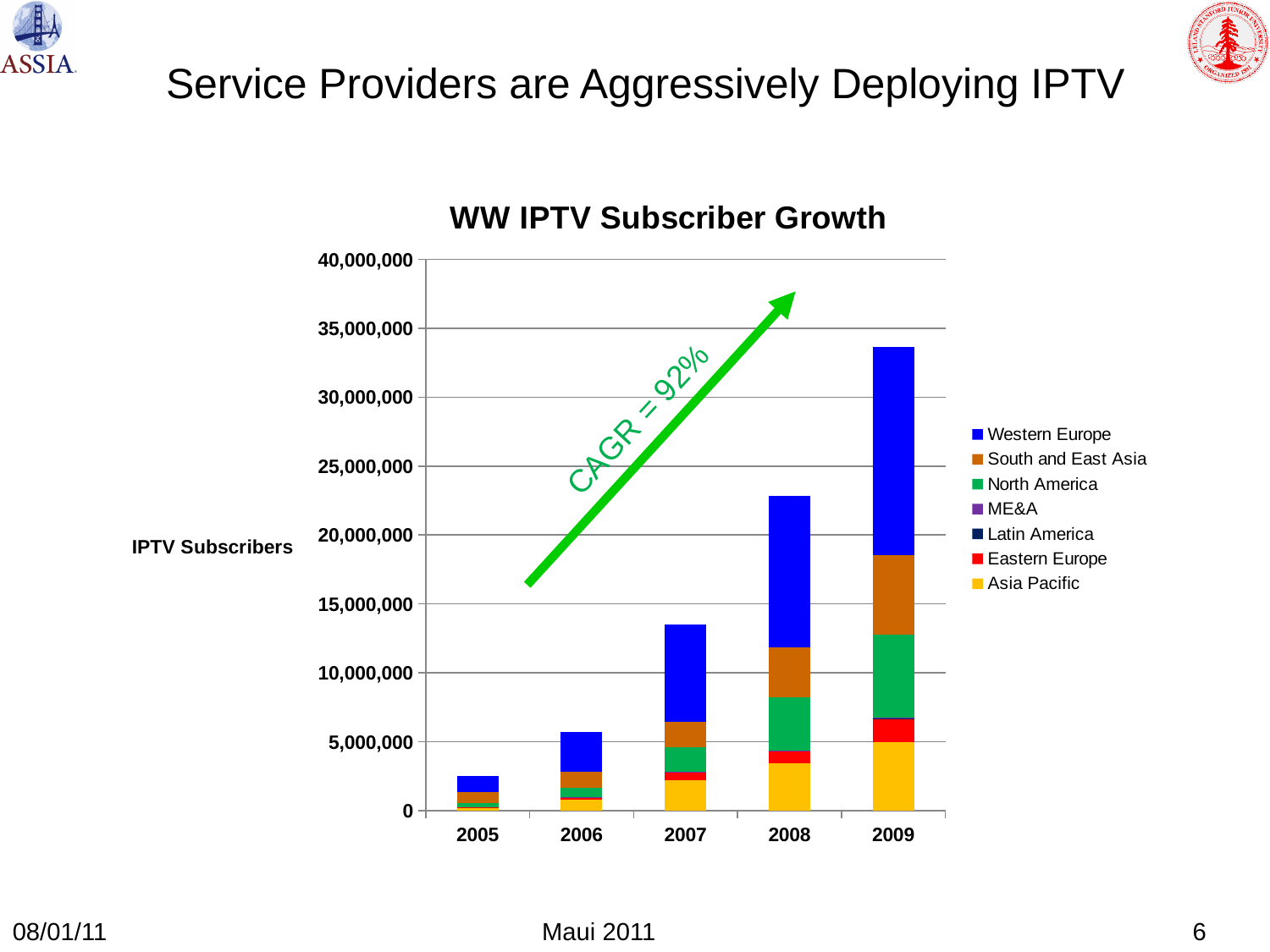
What is the title of the chart? WW IPTV Subscriber Growth Which year has the highest total number of IPTV subscribers? 2009 Is the total for 2005 greater or less than 5,000,000? less How many years are shown on the x axis? 5 Is the total for 2007 greater or less than 15,000,000? less Is the total for 2009 greater or less than 30,000,000? greater Which year has the lowest total number of IPTV subscribers? 2005 What CAGR is annotated on the chart? 92% What kind of chart is shown on the slide? Stacked bar chart Do total IPTV subscribers rise or fall from 2005 to 2009? Rise How many series does the legend list? 7